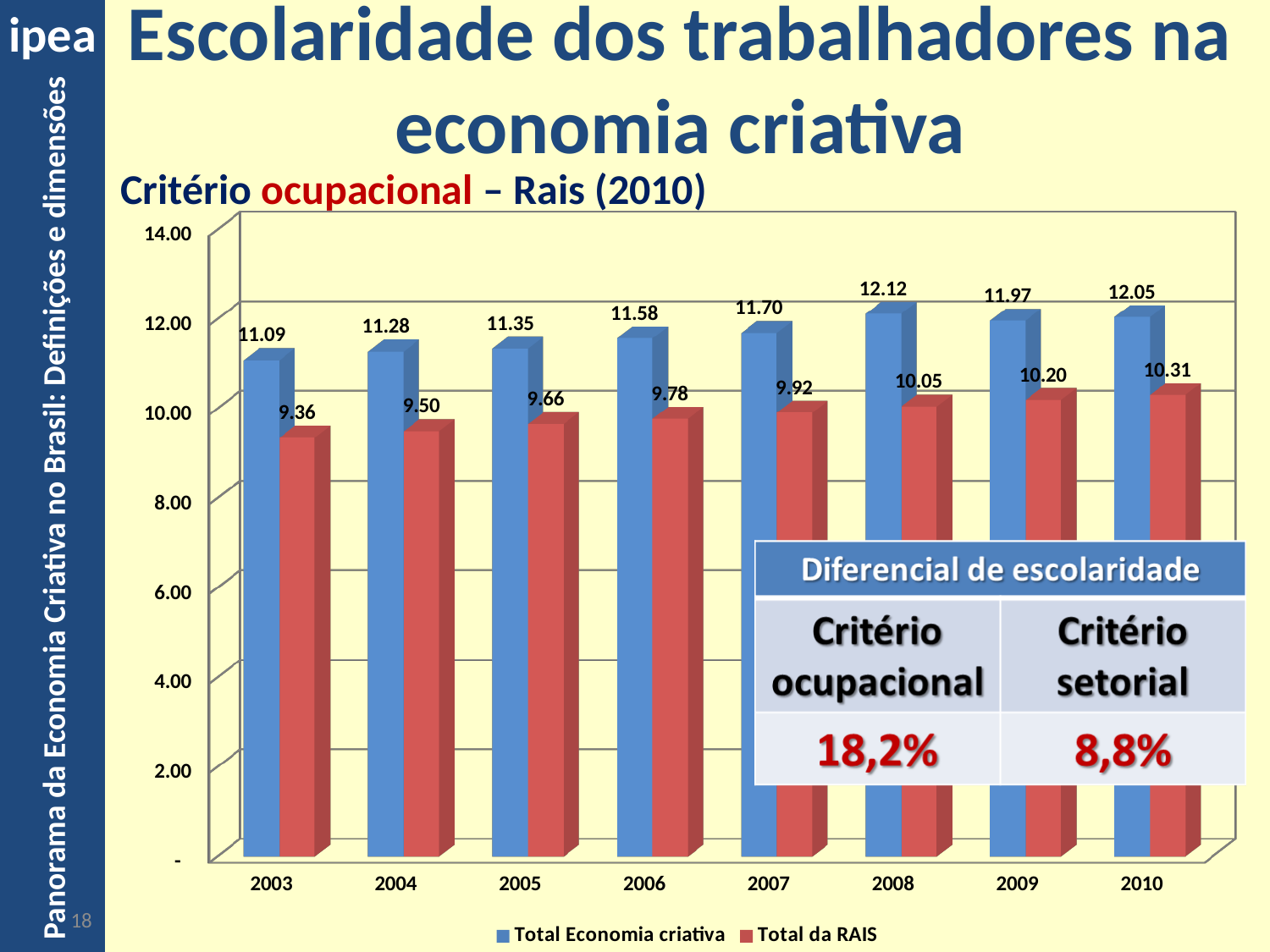
In which year is Total Economia criativa highest? 2008 How many series does the legend list? 2 What is the difference between Total Economia criativa and Total da RAIS in 2010? 1.74 What kind of chart is shown? bar chart In which year is Total da RAIS lowest? 2003 Is the value for Total da RAIS in 2004 greater or less than 10.00? less What is the value for Total da RAIS in 2010? 10.31 Which is larger in 2007: Total Economia criativa or Total da RAIS? Total Economia criativa What is the value for Total da RAIS in 2006? 9.78 Does Total da RAIS rise or fall from 2003 to 2010? rise What is the value for Total Economia criativa in 2003? 11.09 How many years are shown on the x axis? 8